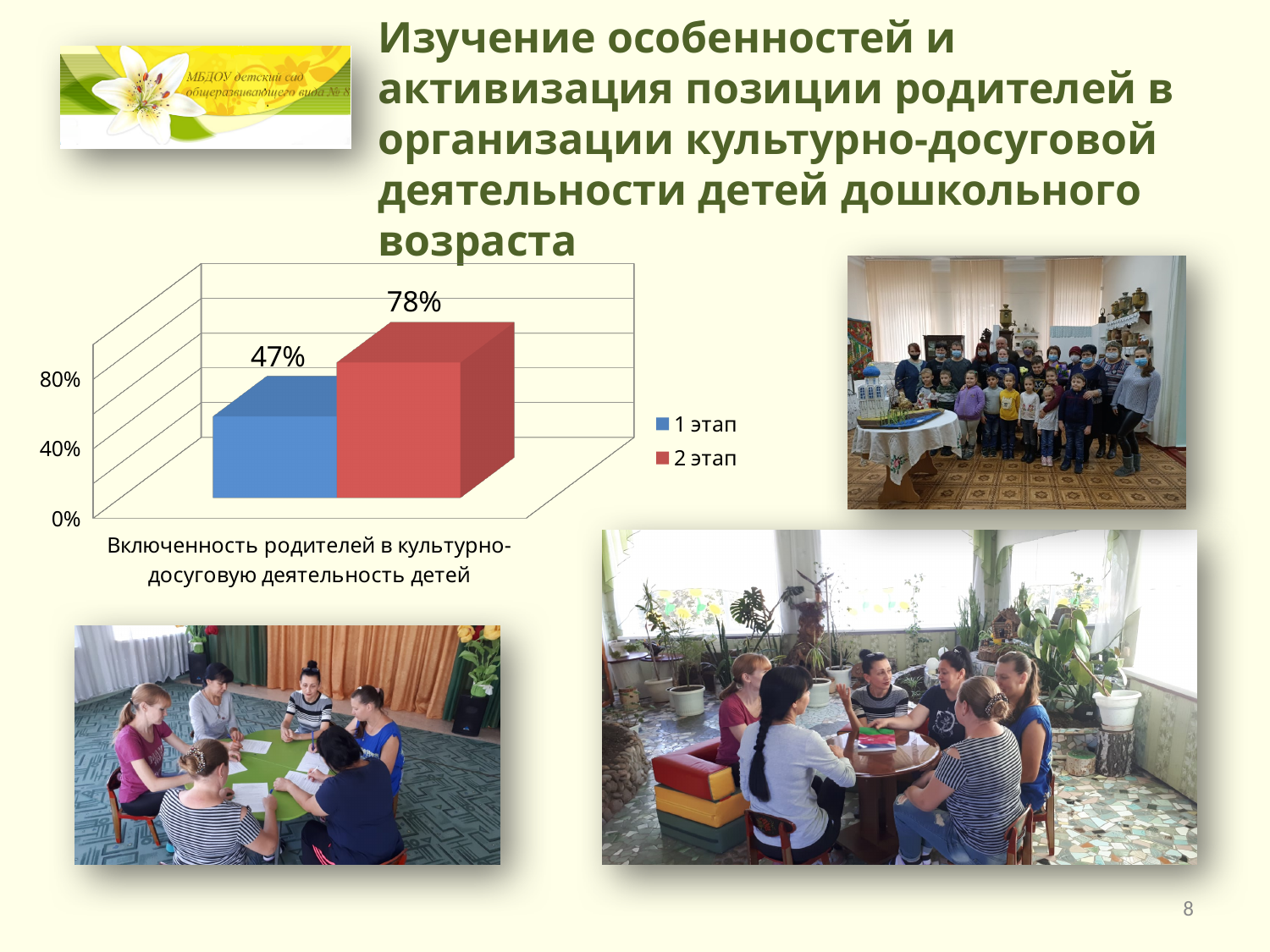
Is the value for 1 этап greater or less than 40%? greater Which series has the higher value, 1 этап or 2 этап? 2 этап How many series does the legend list? 2 What is the difference between the values for 2 этап and 1 этап? 31% What kind of chart is shown on the slide? bar chart Which series has the lowest value in the chart? 1 этап What is the value for 2 этап in the chart? 78% What is the category label shown below the chart? Включенность родителей в культурно-досуговую деятельность детей What is the value for 1 этап in the chart? 47% How many categories are shown on the x axis of the chart? 1 Is the value for 2 этап greater or less than 80%? less What colour is the bar for 2 этап? red